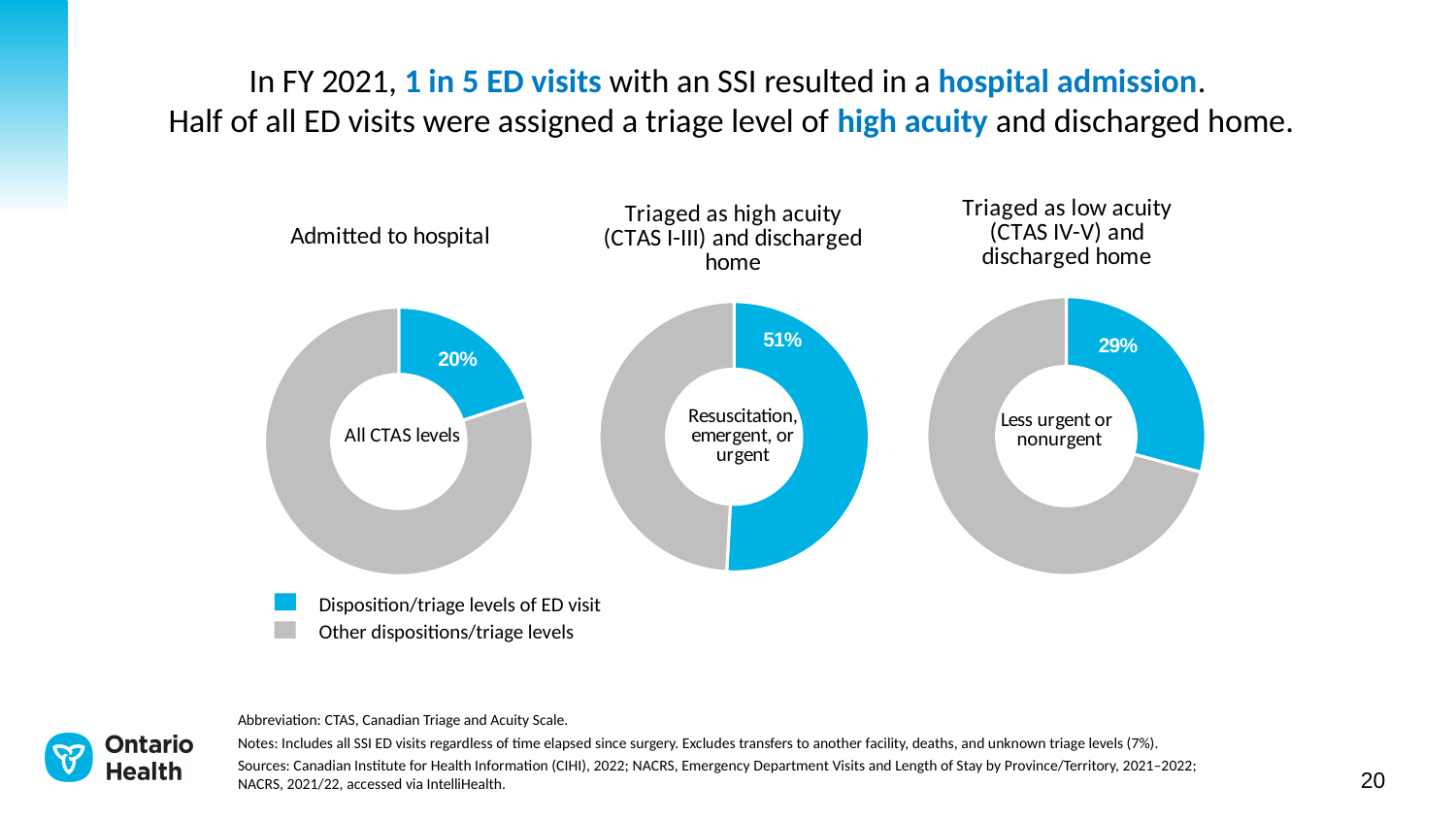
Across the three charts, which disposition/triage category has the highest highlighted percentage? Triaged as high acuity (CTAS I-III) and discharged home What kind of chart is used on this slide? Pie (donut) chart What label appears in the centre of the 'Admitted to hospital' chart? All CTAS levels How many entries does the legend list? 2 Across the three charts, which disposition/triage category has the lowest highlighted percentage? Admitted to hospital In the 'Triaged as low acuity (CTAS IV-V) and discharged home' chart, what percentage is shown for the highlighted slice? 29% How many donut charts are shown on the slide? 3 What is the difference between the highlighted percentage in the 'Triaged as high acuity' chart and the 'Admitted to hospital' chart? 31% In the 'Admitted to hospital' chart, what percentage of ED visits is shown for the highlighted slice? 20% In the 'Triaged as high acuity (CTAS I-III) and discharged home' chart, what percentage is shown for the highlighted slice? 51% Which is larger: the highlighted percentage in the 'Triaged as high acuity' chart or in the 'Triaged as low acuity' chart? Triaged as high acuity What is the difference between the highlighted percentage in the 'Triaged as low acuity' chart and the 'Admitted to hospital' chart? 9%